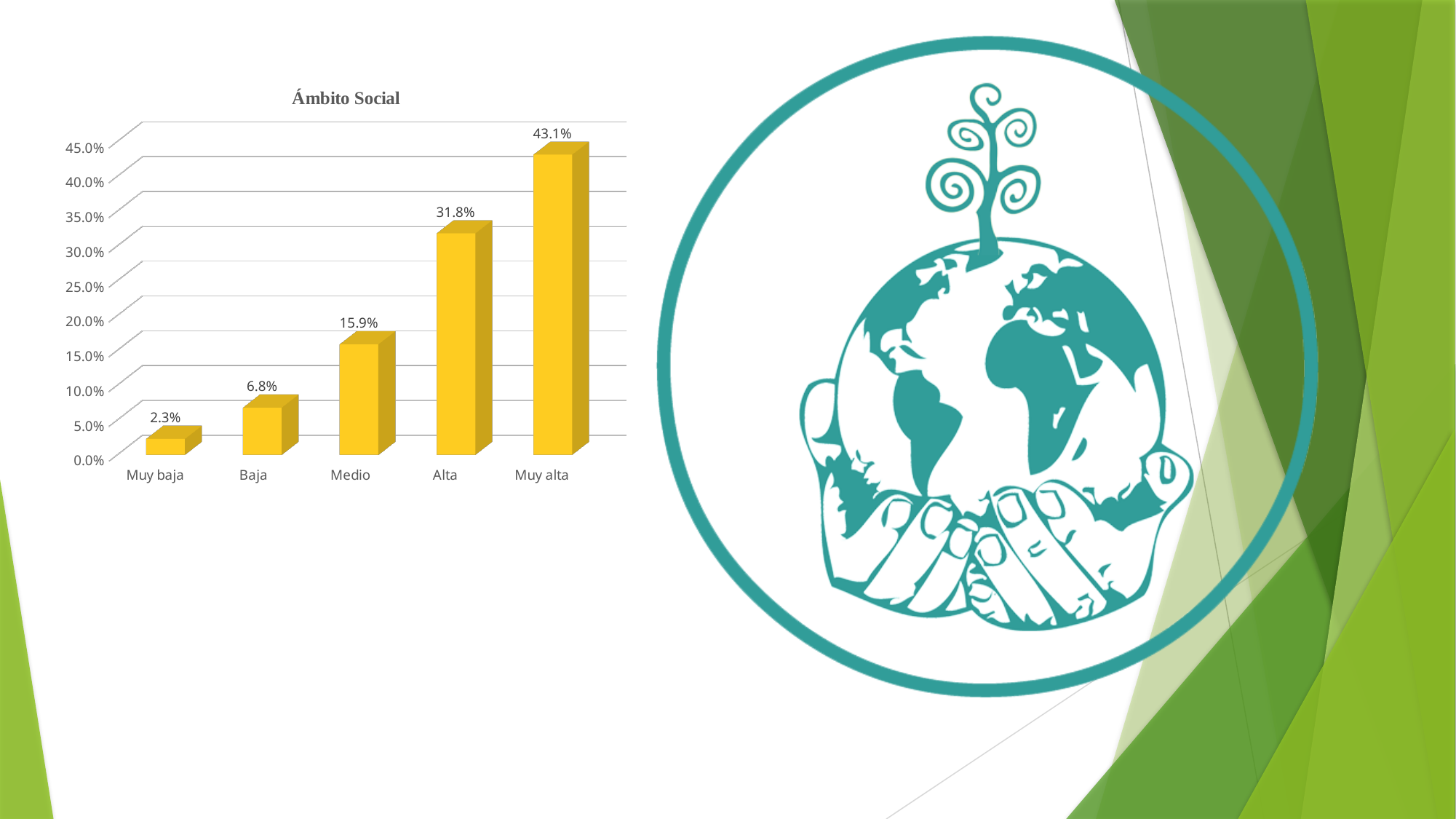
What is the difference between the values for Muy alta and Alta? 11.3% What is the difference between the values for Medio and Baja? 9.1% What is the value for Baja? 6.8% Which category has the highest value? Muy alta Which is larger, the value for Alta or the value for Medio? Alta What is the value for Medio? 15.9% What kind of chart is shown? Bar chart Do the values rise or fall from Muy baja to Muy alta? Rise Is the value for Alta greater or less than 30.0%? greater What is the value for Muy alta? 43.1% How many categories are shown on the x axis? 5 Which category has the lowest value? Muy baja